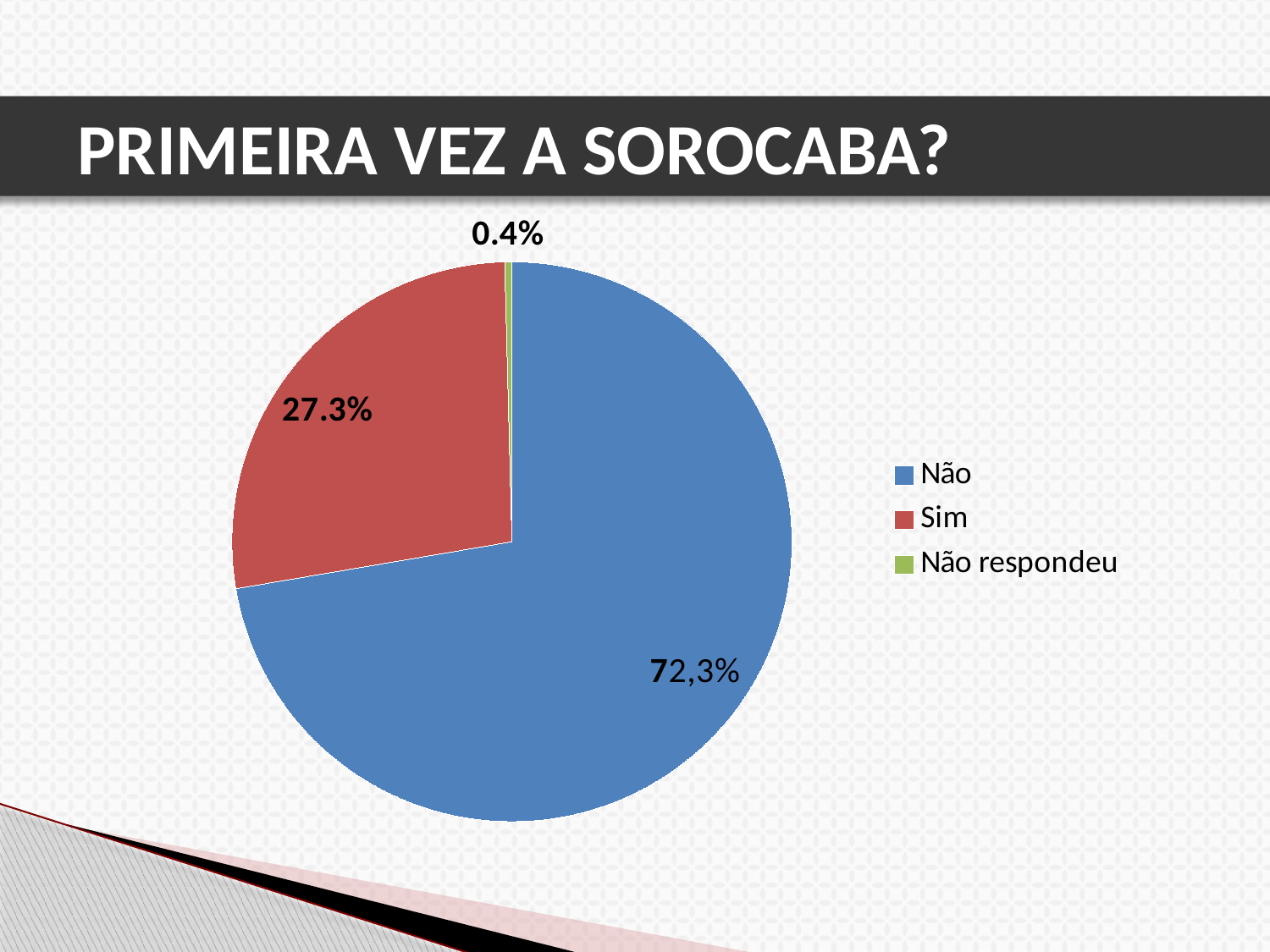
Which slice is larger, Sim or Não? Não What colour is the Sim slice in the pie chart? red What is the value shown for the Não slice? 72,3% Which category has the smallest slice of the pie? Não respondeu Which slice is larger, Sim or Não respondeu? Sim What is the title of the slide containing the pie chart? PRIMEIRA VEZ A SOROCABA? What is the value shown for the Não respondeu slice? 0.4% What kind of chart is shown on the slide? pie chart How many entries does the legend list? 3 What is the value shown for the Sim slice? 27.3% Which category has the largest slice of the pie? Não How many slices does the pie chart have? 3